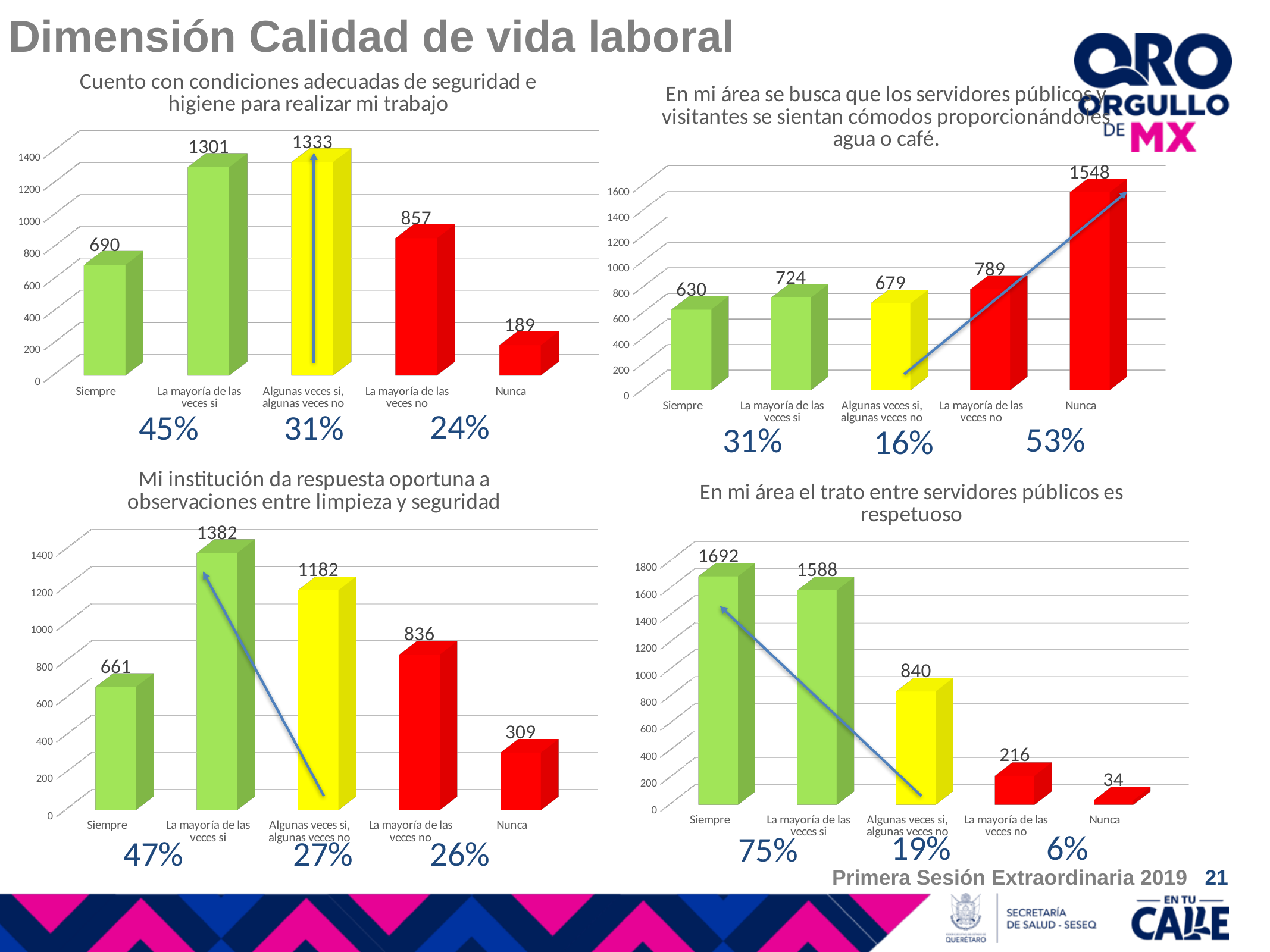
In the top-left chart (Cuento con condiciones adecuadas de seguridad e higiene para realizar mi trabajo), which category has the highest value? Algunas veces si, algunas veces no In the top-left chart (Cuento con condiciones adecuadas de seguridad e higiene para realizar mi trabajo), what is the value for Nunca? 189 How many categories are shown on the x axis of the bottom-left chart (Mi institución da respuesta oportuna a observaciones entre limpieza y seguridad)? 5 In the top-right chart (En mi área se busca que los servidores públicos y visitantes se sientan cómodos proporcionándoles agua o café), which is larger: La mayoría de las veces si or Algunas veces si, algunas veces no? La mayoría de las veces si In the bottom-left chart (Mi institución da respuesta oportuna a observaciones entre limpieza y seguridad), what is the value for La mayoría de las veces si? 1382 In the bottom-right chart (En mi área el trato entre servidores públicos es respetuoso), do the values rise or fall from Siempre to Nunca along the x axis? fall In the top-right chart (En mi área se busca que los servidores públicos y visitantes se sientan cómodos proporcionándoles agua o café), which category has the lowest value? Siempre In the bottom-left chart (Mi institución da respuesta oportuna a observaciones entre limpieza y seguridad), what is the difference between the values for Algunas veces si, algunas veces no and La mayoría de las veces no? 346 In the bottom-right chart (En mi área el trato entre servidores públicos es respetuoso), what is the value for Siempre? 1692 In the top-right chart (En mi área se busca que los servidores públicos y visitantes se sientan cómodos proporcionándoles agua o café), what is the value for Nunca? 1548 In the top-left chart (Cuento con condiciones adecuadas de seguridad e higiene para realizar mi trabajo), what is the difference between the values for La mayoría de las veces si and Siempre? 611 In the bottom-right chart (En mi área el trato entre servidores públicos es respetuoso), which category has the lowest value? Nunca